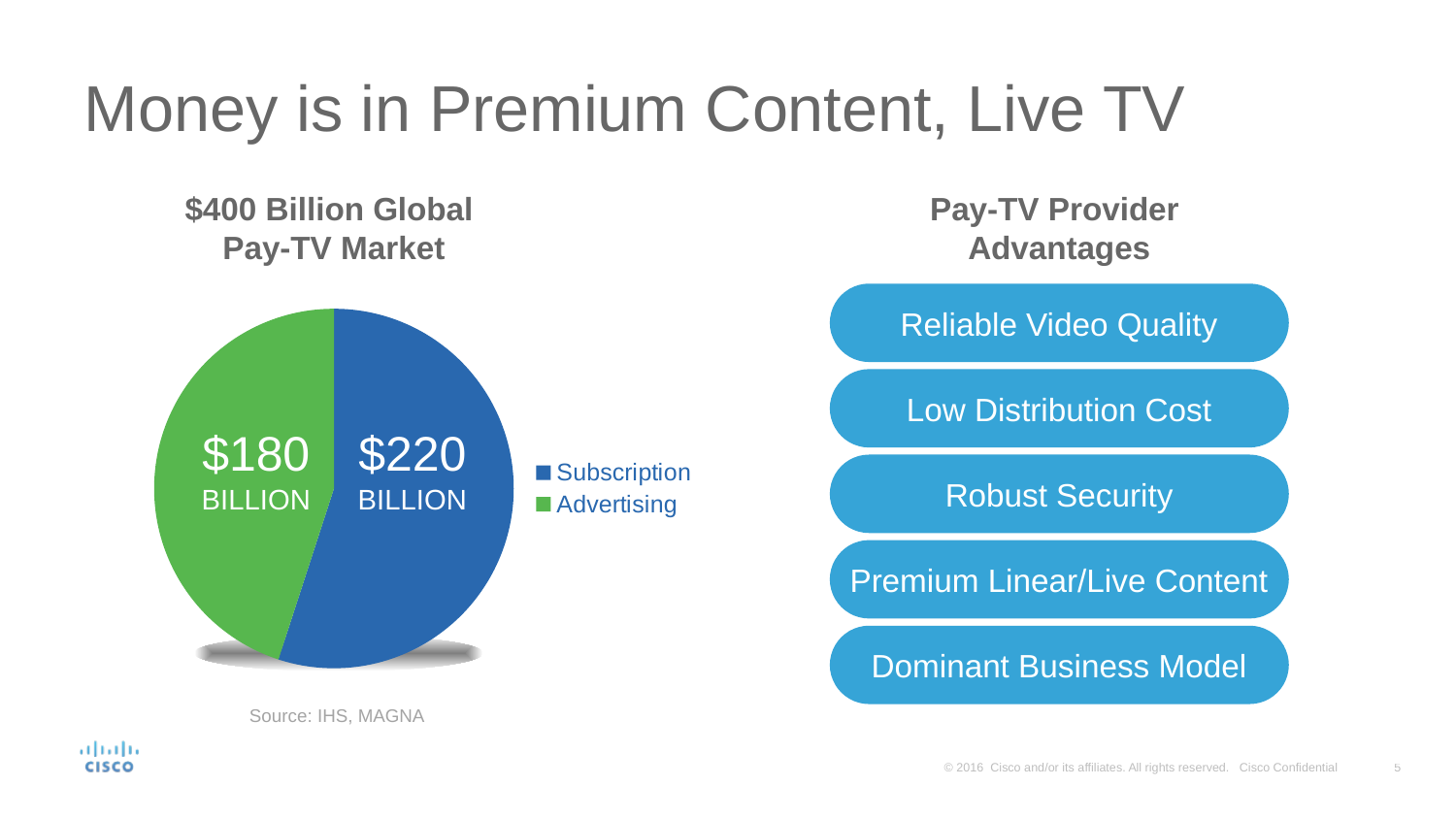
What is the title of the pie chart? $400 Billion Global Pay-TV Market What share of the pie chart does the Subscription slice represent? 55% Which slice of the pie chart is the smallest? Advertising What is the total of the two slices in the pie chart? $400 Billion Which slice of the pie chart is the largest? Subscription What is the value of the Advertising slice in the pie chart? $180 Billion What is the difference between the Subscription and Advertising values in the pie chart? $40 Billion How many slices does the pie chart have? 2 What is the value of the Subscription slice in the pie chart? $220 Billion What kind of chart is shown on the slide? pie chart Which is larger in the pie chart, Subscription or Advertising? Subscription How many entries does the pie chart's legend list? 2